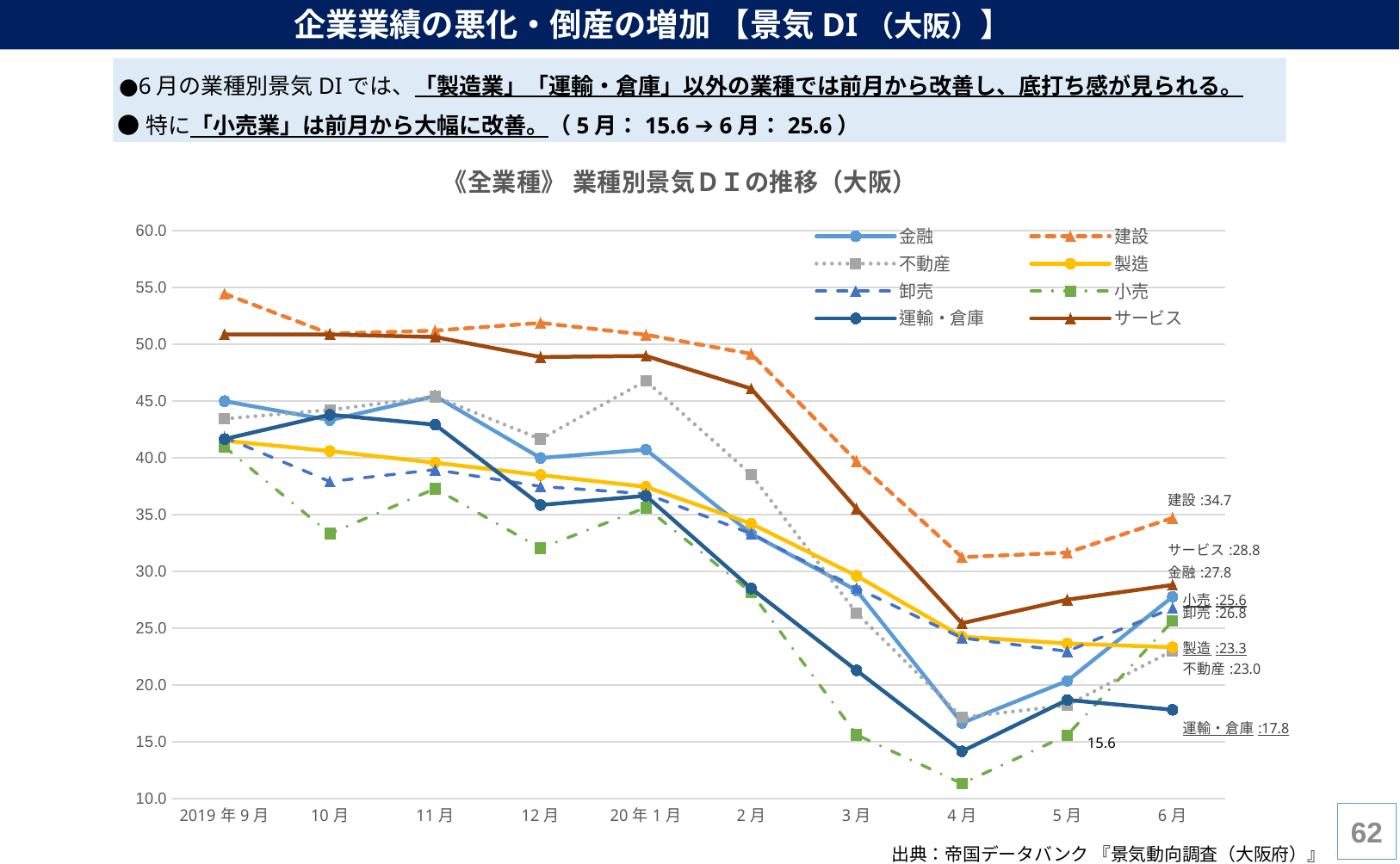
What kind of chart is this? line chart Which series has the highest value in 6月? 建設 How many series does the legend list? 8 Is the value for 建設 in 2019年9月 greater or less than 50.0? greater What is the value for 運輸・倉庫 in 6月? 17.8 What is the value for 建設 in 6月? 34.7 What is the value for 小売 in 5月? 15.6 In 6月, which is larger, 金融 or 卸売? 金融 How many months are shown on the x axis? 10 Which series has the lowest value in 6月? 運輸・倉庫 By how much did 小売 increase from 5月 to 6月? 10.0 What is the difference between 建設 and サービス in 6月? 5.9